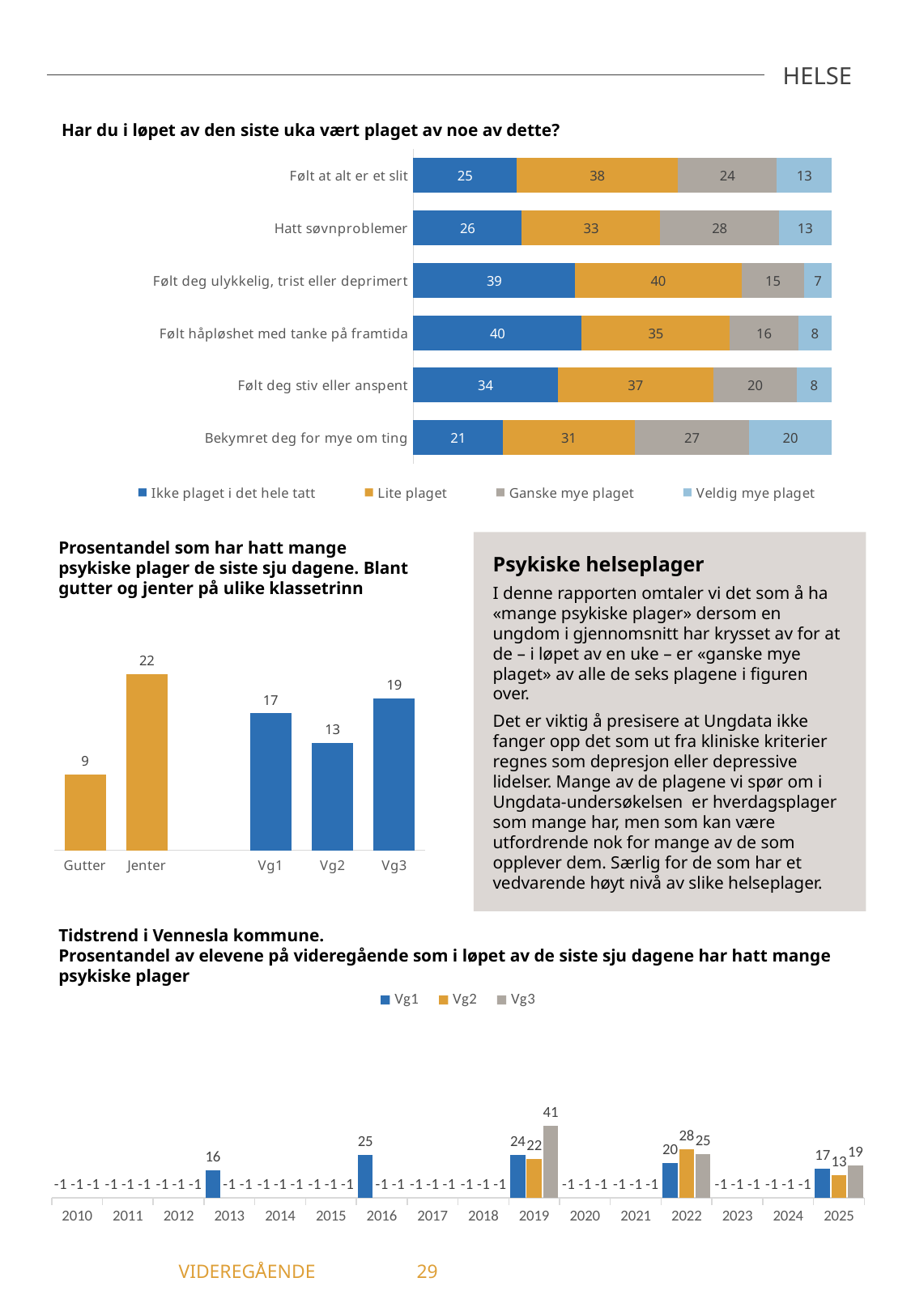
In the chart 'Prosentandel som har hatt mange psykiske plager de siste sju dagene', which is larger, Vg1 or Vg2? Vg1 What kind of chart is 'Har du i løpet av den siste uka vært plaget av noe av dette?'? Stacked bar chart In the chart 'Har du i løpet av den siste uka vært plaget av noe av dette?', what is the difference between 'Ikke plaget i det hele tatt' for 'Følt håpløshet med tanke på framtida' and for 'Bekymret deg for mye om ting'? 19 In the chart 'Har du i løpet av den siste uka vært plaget av noe av dette?', which category has the highest value for 'Veldig mye plaget'? Bekymret deg for mye om ting In the chart 'Prosentandel som har hatt mange psykiske plager de siste sju dagene', which category has the lowest value? Gutter In the chart 'Prosentandel som har hatt mange psykiske plager de siste sju dagene', what is the value for Jenter? 22 In the chart 'Tidstrend i Vennesla kommune', what is the difference between Vg2 in 2022 and Vg2 in 2025? 15 How many categories are shown in the chart 'Prosentandel som har hatt mange psykiske plager de siste sju dagene'? 5 In the chart 'Tidstrend i Vennesla kommune', what is the value for Vg3 in 2019? 41 In the chart 'Har du i løpet av den siste uka vært plaget av noe av dette?', what is the value for 'Lite plaget' in the 'Hatt søvnproblemer' row? 33 In the chart 'Tidstrend i Vennesla kommune', what is the value for Vg1 in 2016? 25 How many series does the legend list in the chart 'Har du i løpet av den siste uka vært plaget av noe av dette?'? 4